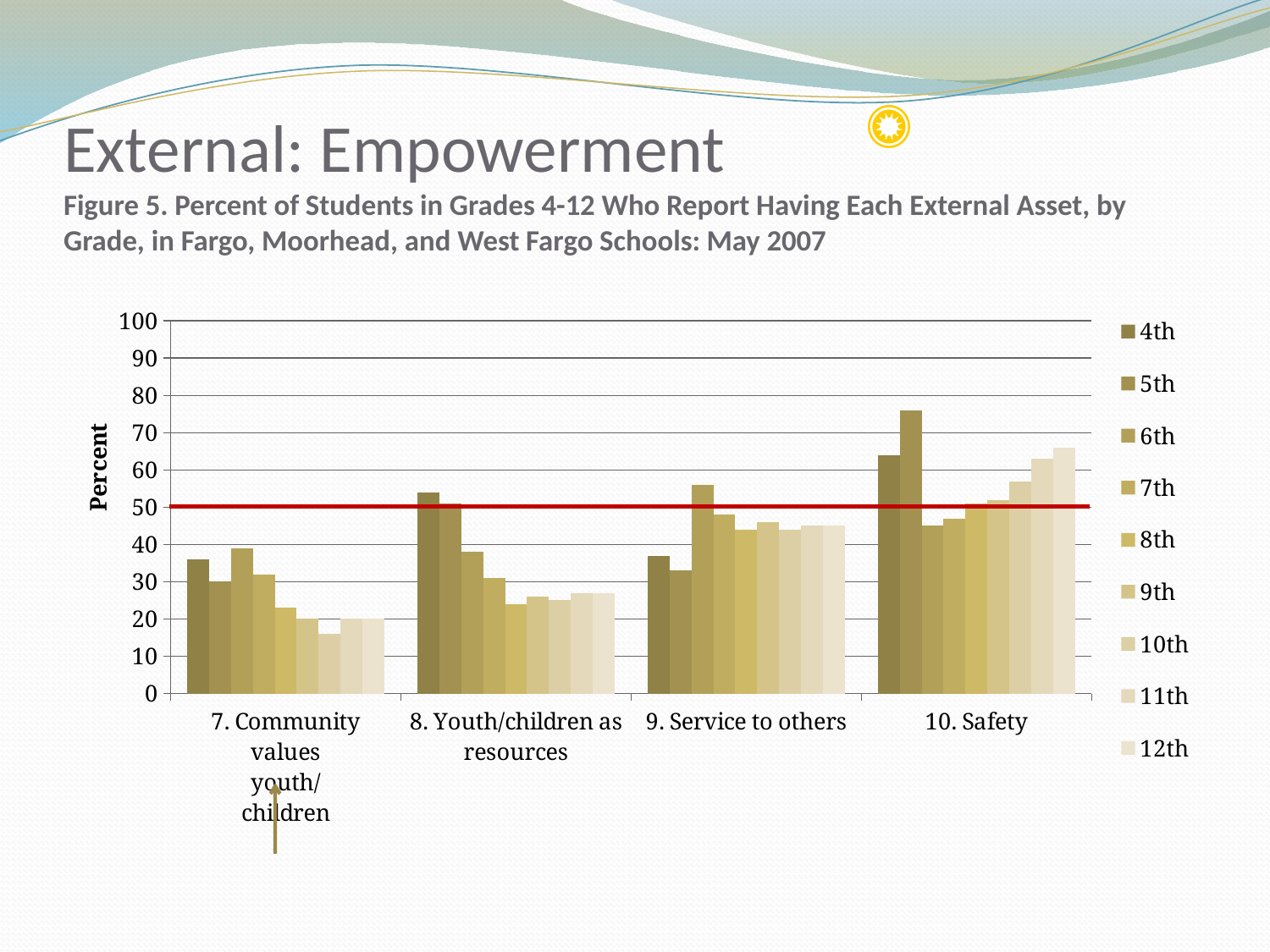
Is the value for 8th grade in 9. Service to others greater or less than 50? less How many asset categories are shown along the x axis? 4 Is the value for 12th grade in 10. Safety greater or less than 60? greater Which asset category has the highest bar for 5th grade? 10. Safety In 10. Safety, do the values rise or fall from 6th grade to 12th grade? rise Is the value for 12th grade in 7. Community values youth/children greater or less than 30? less What value on the y axis does the horizontal red line mark? 50 How many series does the legend list? 9 Which is larger: the 4th grade value for 8. Youth/children as resources or the 4th grade value for 9. Service to others? 8. Youth/children as resources Which asset category has the lowest bar for 12th grade? 7. Community values youth/children What kind of chart is shown on the slide? bar chart